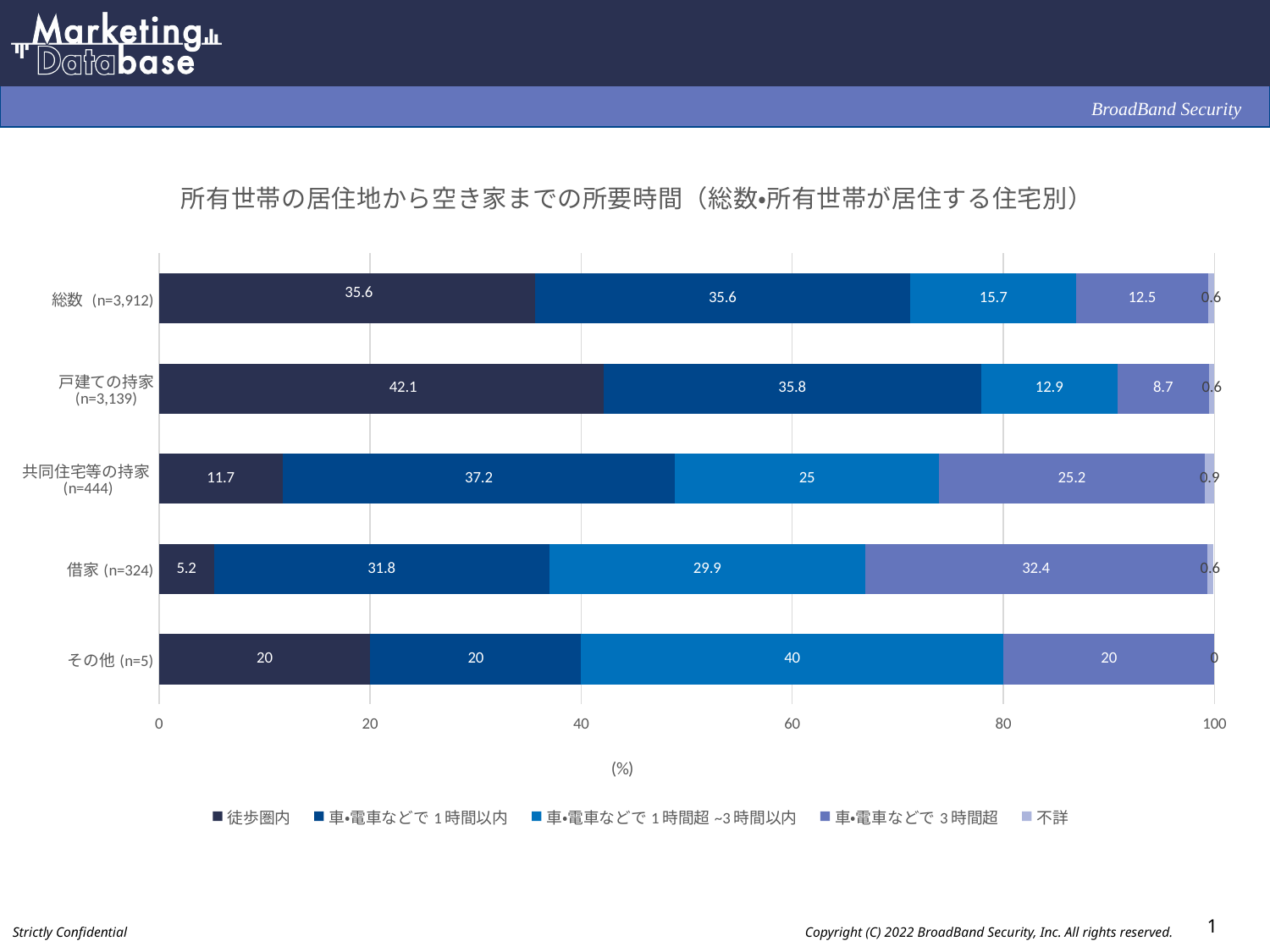
How many series does the legend list? 5 What is the value of 車•電車などで1時間超~3時間以内 for その他 (n=5)? 40 Which category has the highest value for 徒歩圏内? 戸建ての持家 (n=3,139) What type of chart is shown on the slide? Stacked bar chart Which category has the lowest value for 徒歩圏内? 借家 (n=324) What is the value of 車•電車などで3時間超 for 借家 (n=324)? 32.4 What is the difference between the 徒歩圏内 values for 戸建ての持家 (n=3,139) and 共同住宅等の持家 (n=444)? 30.4 What is the value of 徒歩圏内 for 戸建ての持家 (n=3,139)? 42.1 Which is larger: the 車•電車などで3時間超 value for 共同住宅等の持家 (n=444) or for 総数 (n=3,912)? 共同住宅等の持家 (n=444) What unit is shown on the x axis of the chart? (%) What is the value of 不詳 for 共同住宅等の持家 (n=444)? 0.9 How many categories (housing types) are plotted on the chart? 5